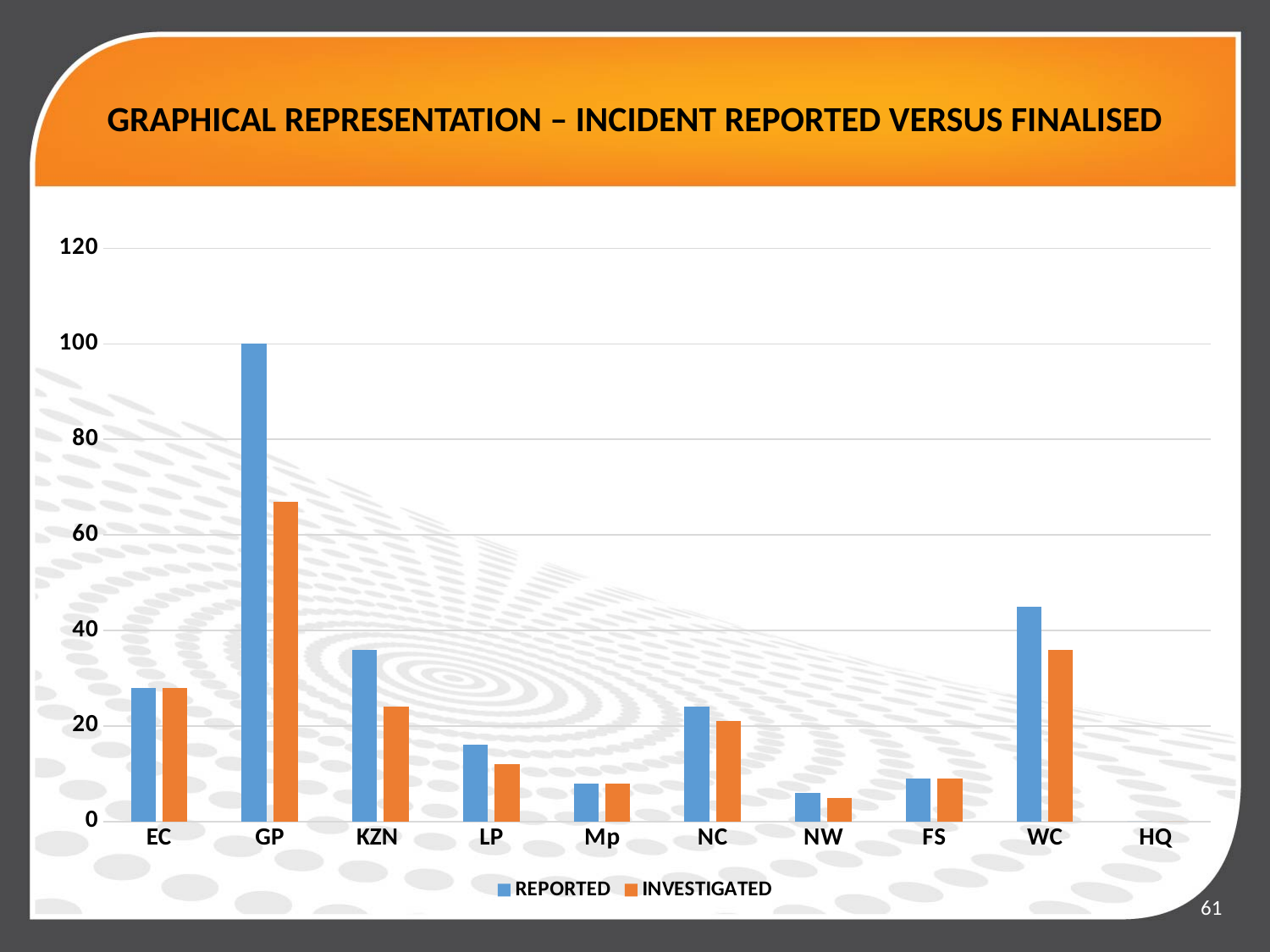
What kind of chart is shown on the slide? bar chart What are the two entries in the legend? REPORTED and INVESTIGATED Is the INVESTIGATED value for GP greater or less than 60? greater How many series does the legend list? 2 Which category has the highest INVESTIGATED value? GP Is the REPORTED value for WC greater or less than 40? greater Which is larger, the REPORTED value for WC or the REPORTED value for KZN? WC Which category has the highest REPORTED value? GP Which category has the lowest REPORTED value? HQ Is the REPORTED value for KZN greater or less than 40? less How many categories are shown on the x axis? 10 What is the REPORTED value for GP? 100